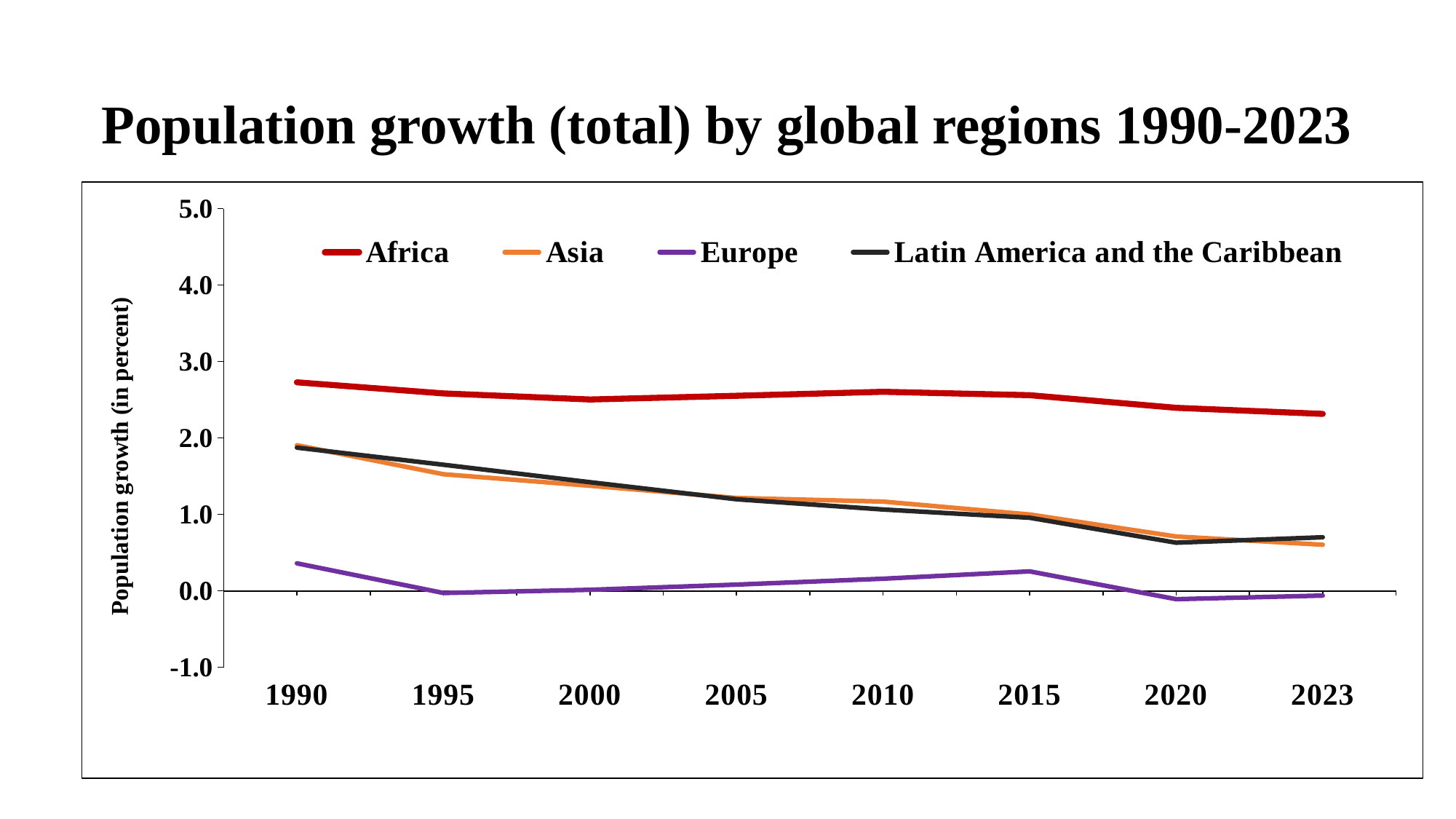
Is the value for Africa in 1990 greater or less than 2.0? greater Is the value for Europe in 2020 greater or less than 0.0? less Is the value for Latin America and the Caribbean in 1990 greater or less than 1.0? greater Does the Asia line rise or fall from 1990 to 2023? falls Which is larger in 2010, the value for Africa or the value for Asia? Africa How many years are labelled along the x axis? 8 What kind of chart is shown on the slide? line chart How many series does the legend list? 4 Which region has the highest population growth in 2023? Africa Which region has the lowest population growth in 2023? Europe What is the title of the y axis? Population growth (in percent)